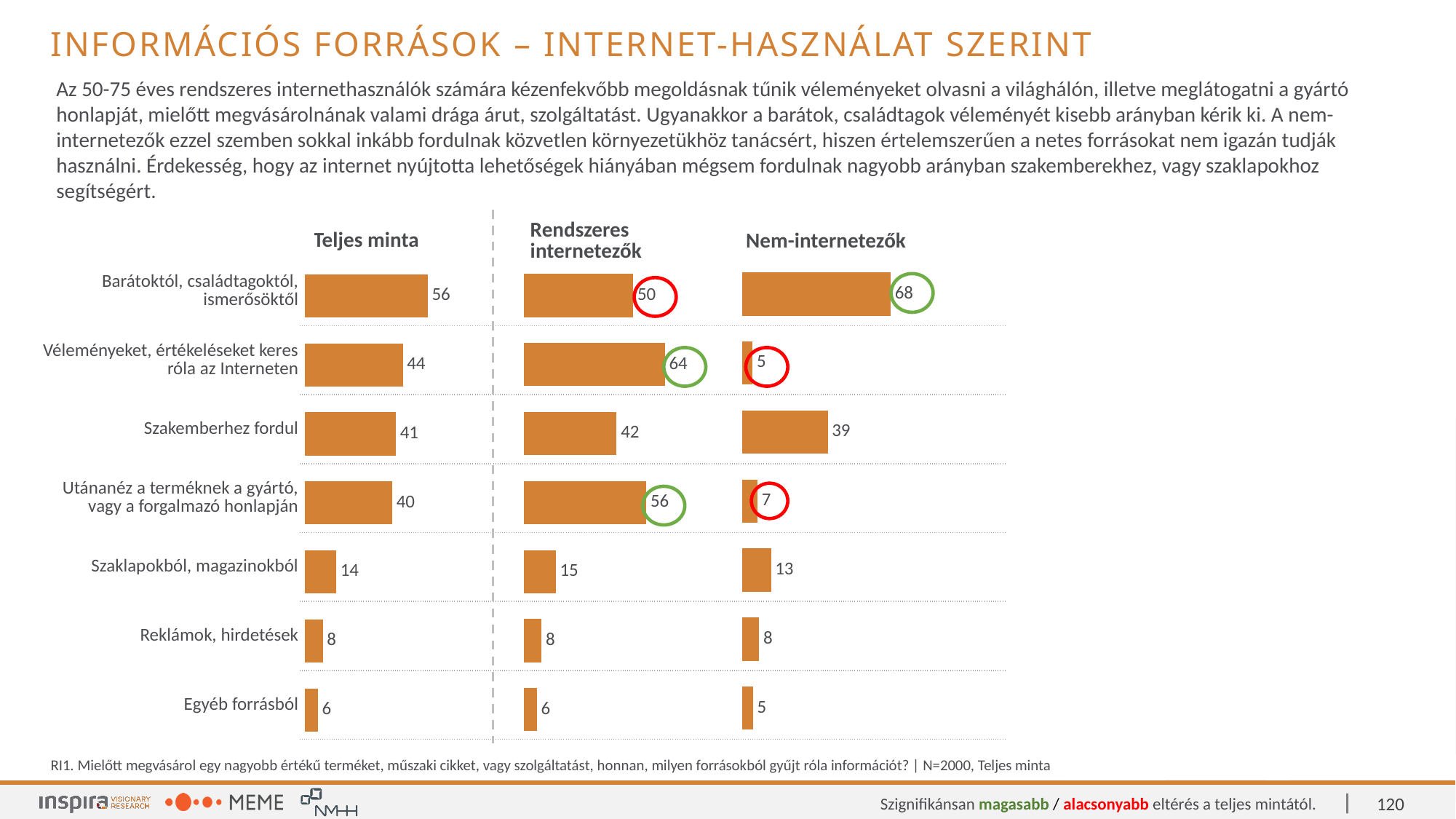
What type of chart is used on this slide? Bar chart In the "Rendszeres internetezők" chart, what is the value for "Véleményeket, értékeléseket keres róla az Interneten"? 64 What are the titles of the three charts on the slide? Teljes minta, Rendszeres internetezők, Nem-internetezők For "Szakemberhez fordul", which is larger: the "Rendszeres internetezők" value or the "Nem-internetezők" value? Rendszeres internetezők How many categories are shown in the "Teljes minta" chart? 7 In the "Teljes minta" chart, which category has the lowest value? Egyéb forrásból In the "Nem-internetezők" chart, what is the value for "Utánanéz a terméknek a gyártó, vagy a forgalmazó honlapján"? 7 In the "Rendszeres internetezők" chart, which category has the lowest value? Egyéb forrásból In the "Teljes minta" chart, what is the value for "Barátoktól, családtagoktól, ismerősöktől"? 56 What is the difference between the "Nem-internetezők" value and the "Rendszeres internetezők" value for "Barátoktól, családtagoktól, ismerősöktől"? 18 In the "Rendszeres internetezők" chart, what is the difference between "Véleményeket, értékeléseket keres róla az Interneten" and "Szaklapokból, magazinokból"? 49 In the "Nem-internetezők" chart, which category has the highest value? Barátoktól, családtagoktól, ismerősöktől